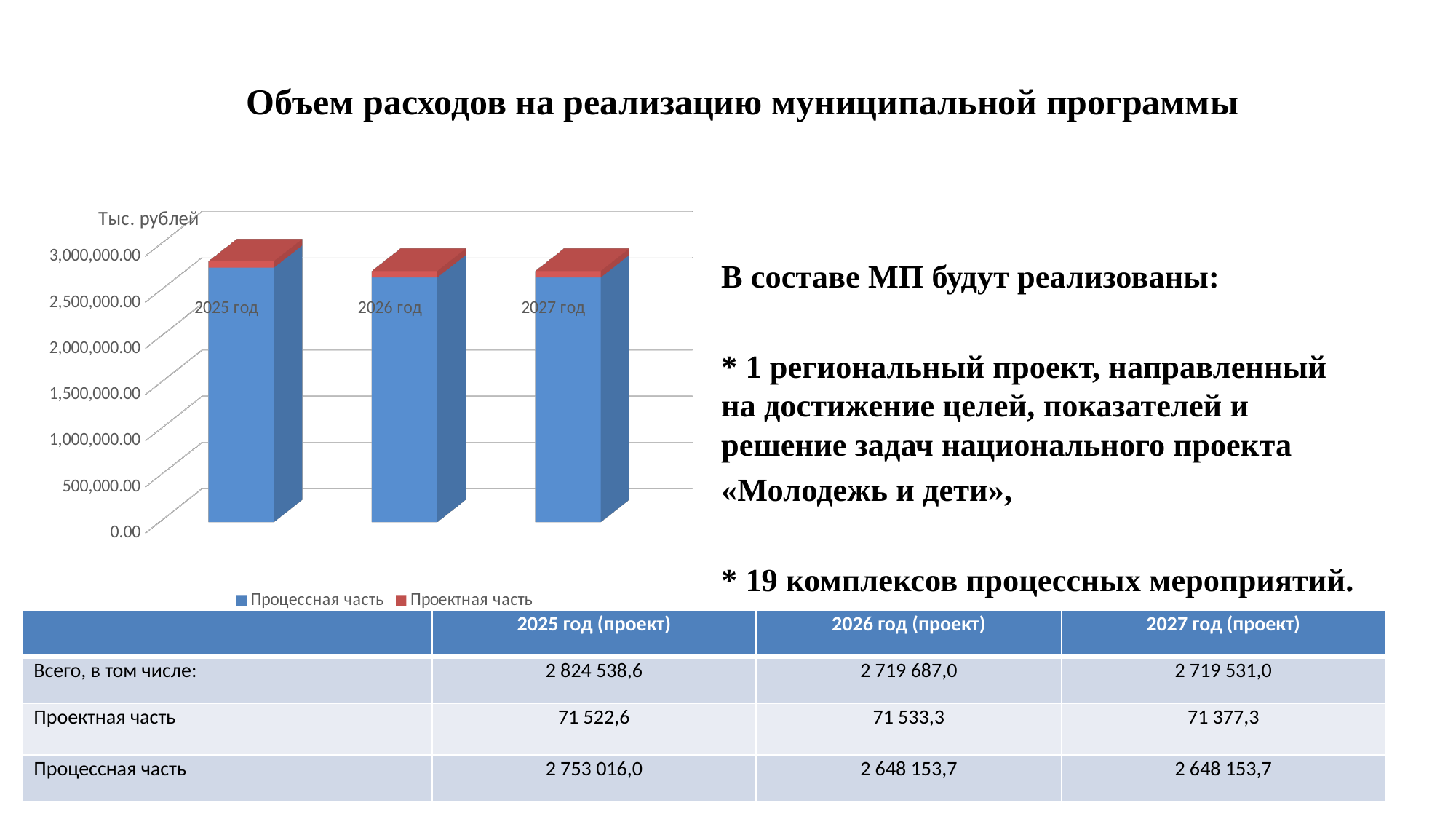
What is the Процессная часть value for 2026 год? 2 648 153,7 Which year has the tallest stacked bar in the chart? 2025 год Is the Проектная часть value for 2026 год greater or less than 500,000.00? less How many years (categories) are plotted in the chart? 3 How many series does the chart legend list? 2 What is the total of the stacked bar for 2025 год (Всего)? 2 824 538,6 Which series is shown in blue in the chart? Процессная часть What kind of chart is shown on the slide? bar chart What is the difference between the total for 2025 год and the total for 2026 год? 104 851,6 What unit label is shown at the top of the chart's vertical axis? Тыс. рублей Is the total value of the 2025 год bar greater or less than 2,500,000.00? greater Do the total bar heights rise or fall from 2025 год to 2027 год? fall